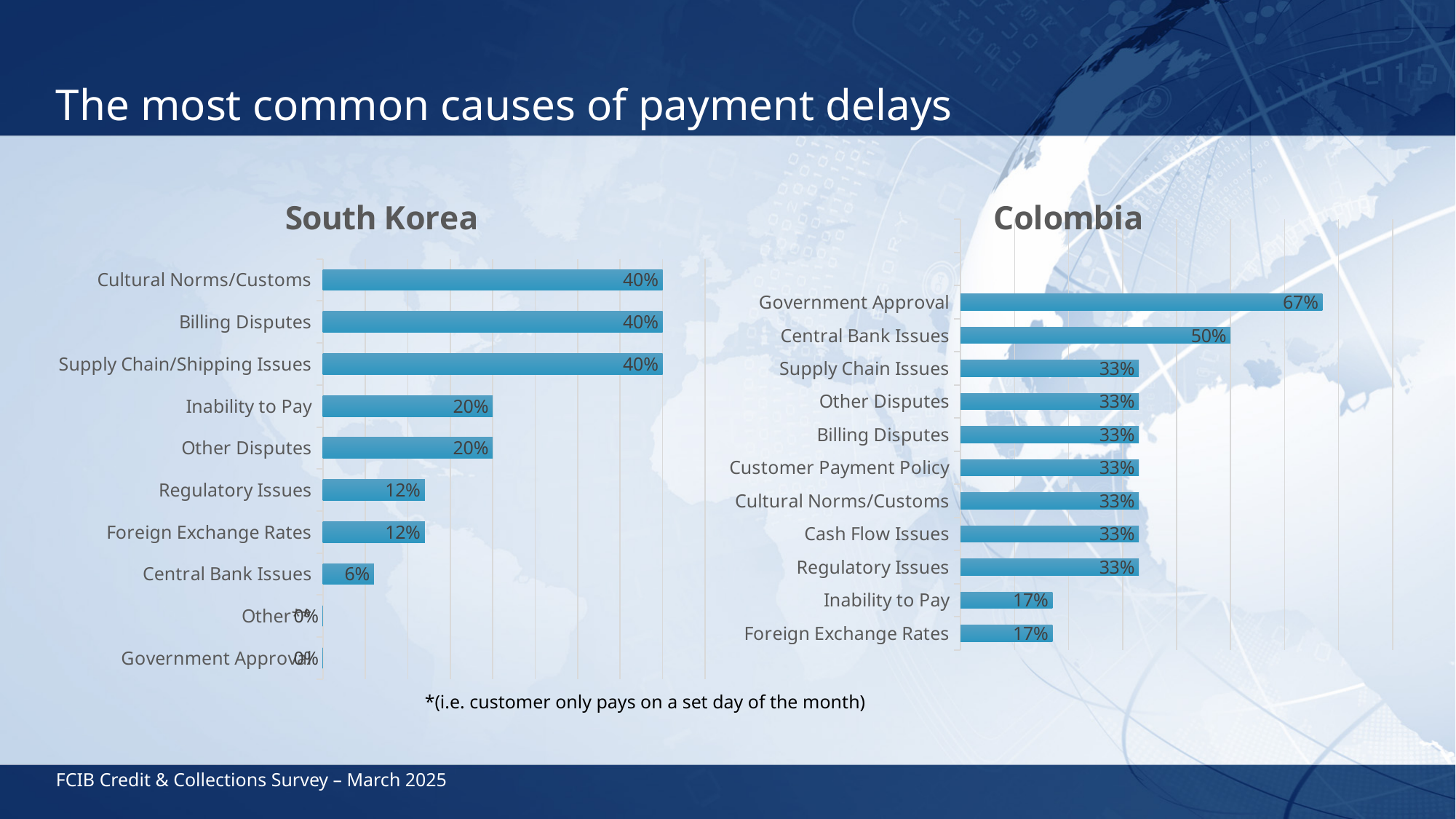
In the South Korea chart, what is the difference between Billing Disputes and Regulatory Issues? 28% How many causes are listed in the South Korea chart? 10 In the South Korea chart, what is the value for Central Bank Issues? 6% What type of chart is the Colombia chart? Bar chart In the Colombia chart, which cause has the highest value? Government Approval In the Colombia chart, what is the value for Inability to Pay? 17% How many causes are listed in the Colombia chart? 11 In the Colombia chart, what is the difference between Government Approval and Central Bank Issues? 17% In the Colombia chart, which is larger: Cash Flow Issues or Foreign Exchange Rates? Cash Flow Issues In the Colombia chart, what is the value for Central Bank Issues? 50% In the South Korea chart, what is the value for Inability to Pay? 20% In the South Korea chart, which is larger: Other Disputes or Foreign Exchange Rates? Other Disputes